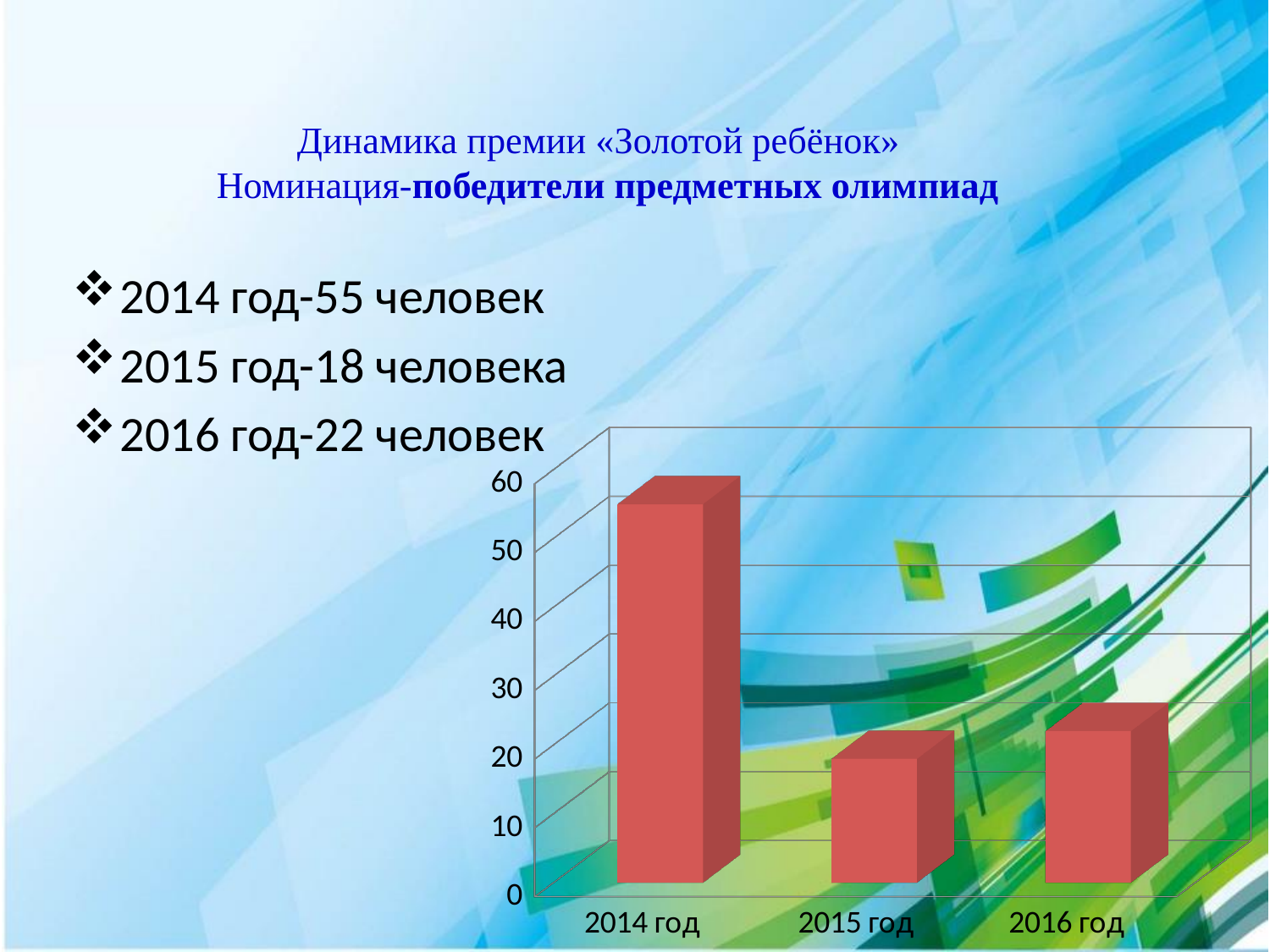
Is the value for 2014 год greater or less than 50? greater Which year has the lowest bar in the chart? 2015 год According to the slide, how many people received the award in 2015? 18 According to the slide, how many people received the award in 2014? 55 How many bars (categories) does the chart show? 3 Which is larger, the value for 2016 год or the value for 2015 год? 2016 год What is the highest value shown on the vertical axis of the chart? 60 Which year has the highest bar in the chart? 2014 год What type of chart is shown on the slide? bar chart Is the value for 2016 год greater or less than 20? greater Is the value for 2015 год greater or less than 20? less What is the difference between the 2014 and 2016 values stated on the slide? 33